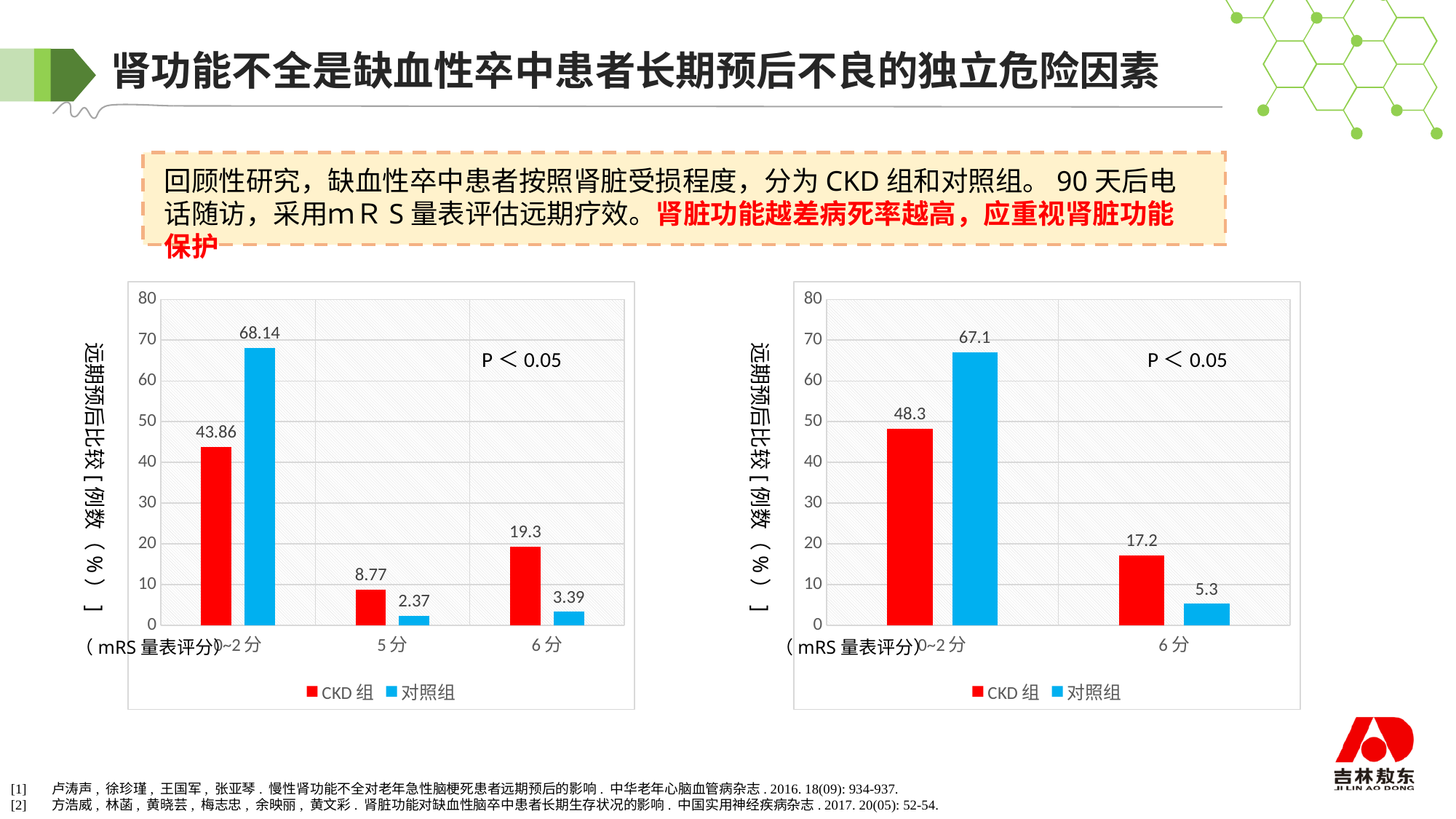
In the left chart, what is the difference between 对照组 and CKD 组 at 0~2 分? 24.28 How many series does the legend of the right chart list? 2 In the left chart, what is the value for CKD 组 at 0~2 分? 43.86 How many categories are shown on the x axis of the left chart? 3 In the left chart, which category has the highest value for 对照组? 0~2 分 In the left chart, what is the value for 对照组 at 5 分? 2.37 In the right chart, what is the value for 对照组 at 6 分? 5.3 What type of chart is the left chart? Bar chart In the left chart, which category has the lowest value for CKD 组? 5 分 In the right chart, which series has the larger value at 0~2 分, CKD 组 or 对照组? 对照组 In the right chart, what is the value for CKD 组 at 0~2 分? 48.3 In the right chart, what is the difference between CKD 组 and 对照组 at 6 分? 11.9